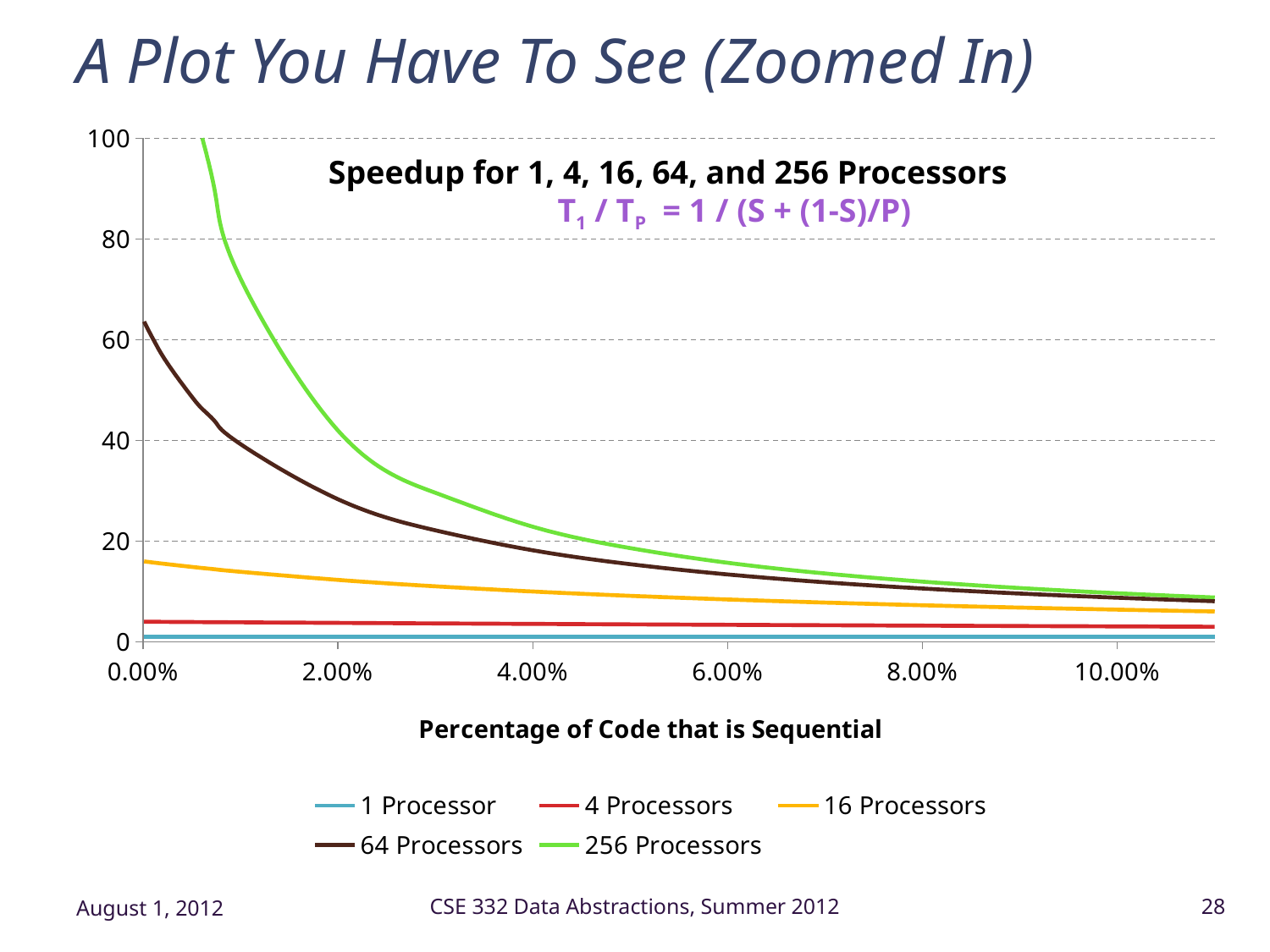
At 2.00%, which series has the higher speedup: 256 Processors or 64 Processors? 256 Processors As the percentage of sequential code increases along the x axis, does the speedup for 256 Processors rise or fall? Fall What kind of chart is shown on the slide? Line chart What is the label of the x axis? Percentage of Code that is Sequential Is the speedup for 64 Processors at 0.00% greater or less than 60? greater Is the speedup for 16 Processors at 0.00% greater or less than 20? less At 0.00%, which series has the higher speedup: 64 Processors or 16 Processors? 64 Processors What is the title of the chart? Speedup for 1, 4, 16, 64, and 256 Processors Which series has the lowest speedup across the whole x axis? 1 Processor How many series does the legend list? 5 Is the speedup for 64 Processors at 6.00% greater or less than 20? less